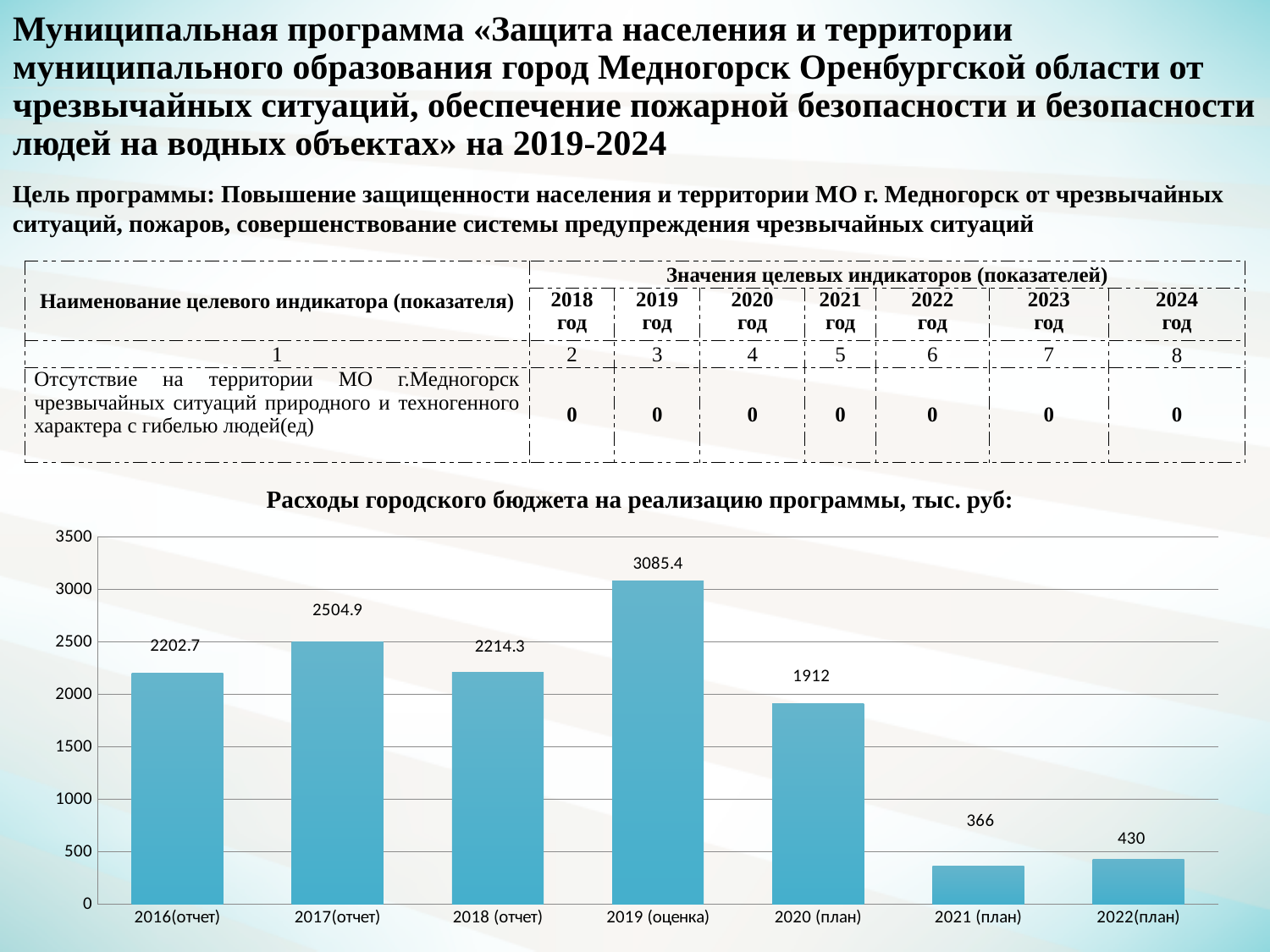
What is the value for 2019 (оценка) in the chart? 3085.4 What is the difference between the values for 2022(план) and 2021 (план)? 64 What is the value for 2021 (план) in the chart? 366 How many categories are shown on the x axis of the chart? 7 Which category has the highest value in the chart? 2019 (оценка) Is the value for 2020 (план) greater or less than 2000? less Which is larger, the value for 2018 (отчет) or the value for 2020 (план)? 2018 (отчет) What is the value for 2016(отчет) in the chart? 2202.7 What kind of chart is shown on the slide? bar chart What is the difference between the values for 2017(отчет) and 2016(отчет)? 302.2 What is the title of the chart? Расходы городского бюджета на реализацию программы, тыс. руб: Which category has the lowest value in the chart? 2021 (план)